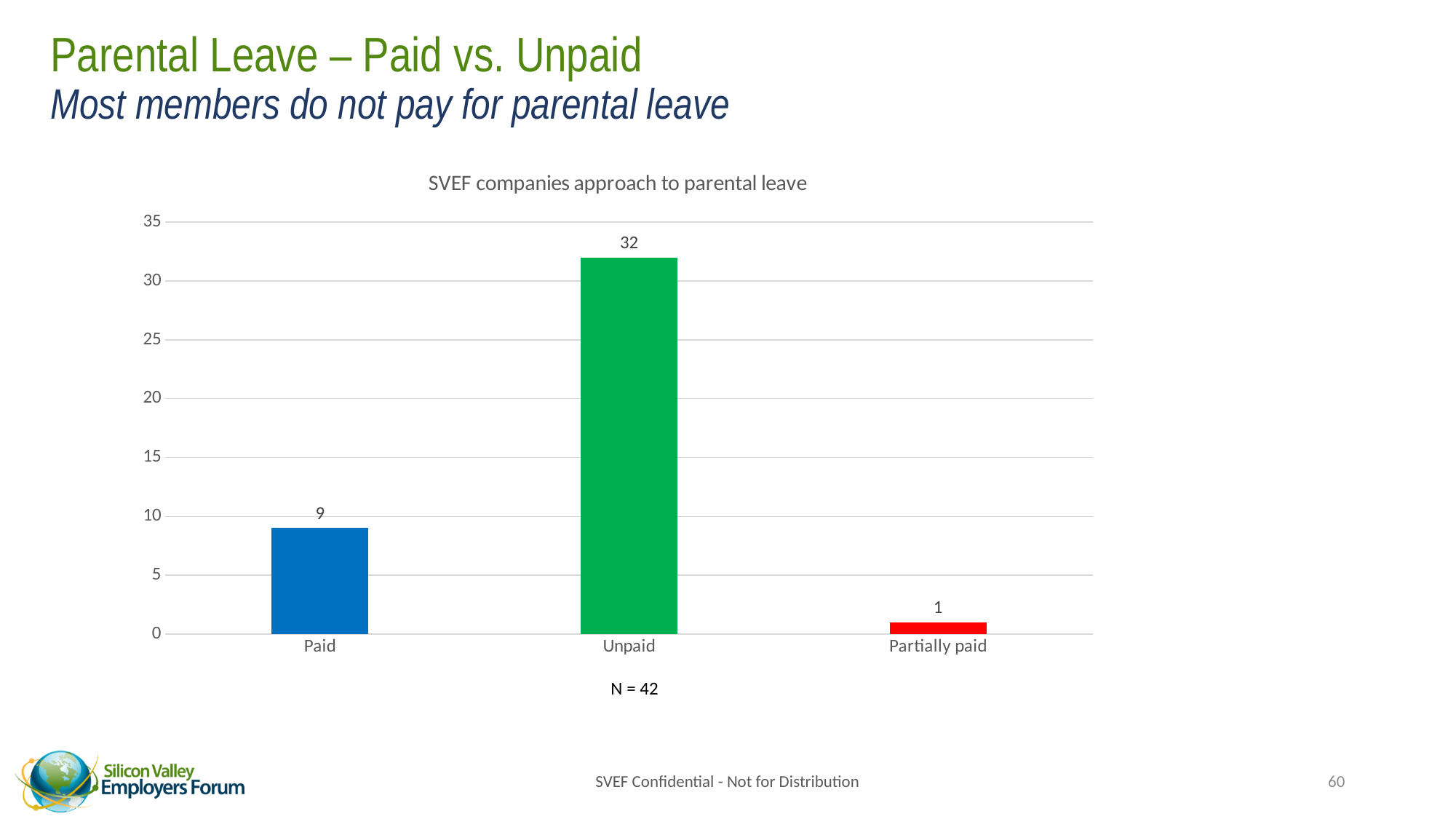
What is the title of the chart? SVEF companies approach to parental leave What is the value for Unpaid? 32 Which category has the lowest value? Partially paid Which category has the highest value? Unpaid Is the value for Unpaid greater or less than 30? greater What is the difference between the values for Unpaid and Paid? 23 How many categories are shown on the x axis? 3 What is the value for Paid? 9 What kind of chart is shown on the slide? bar chart Which is larger, the value for Paid or the value for Partially paid? Paid What colour is the bar for Unpaid? green What is the value for Partially paid? 1